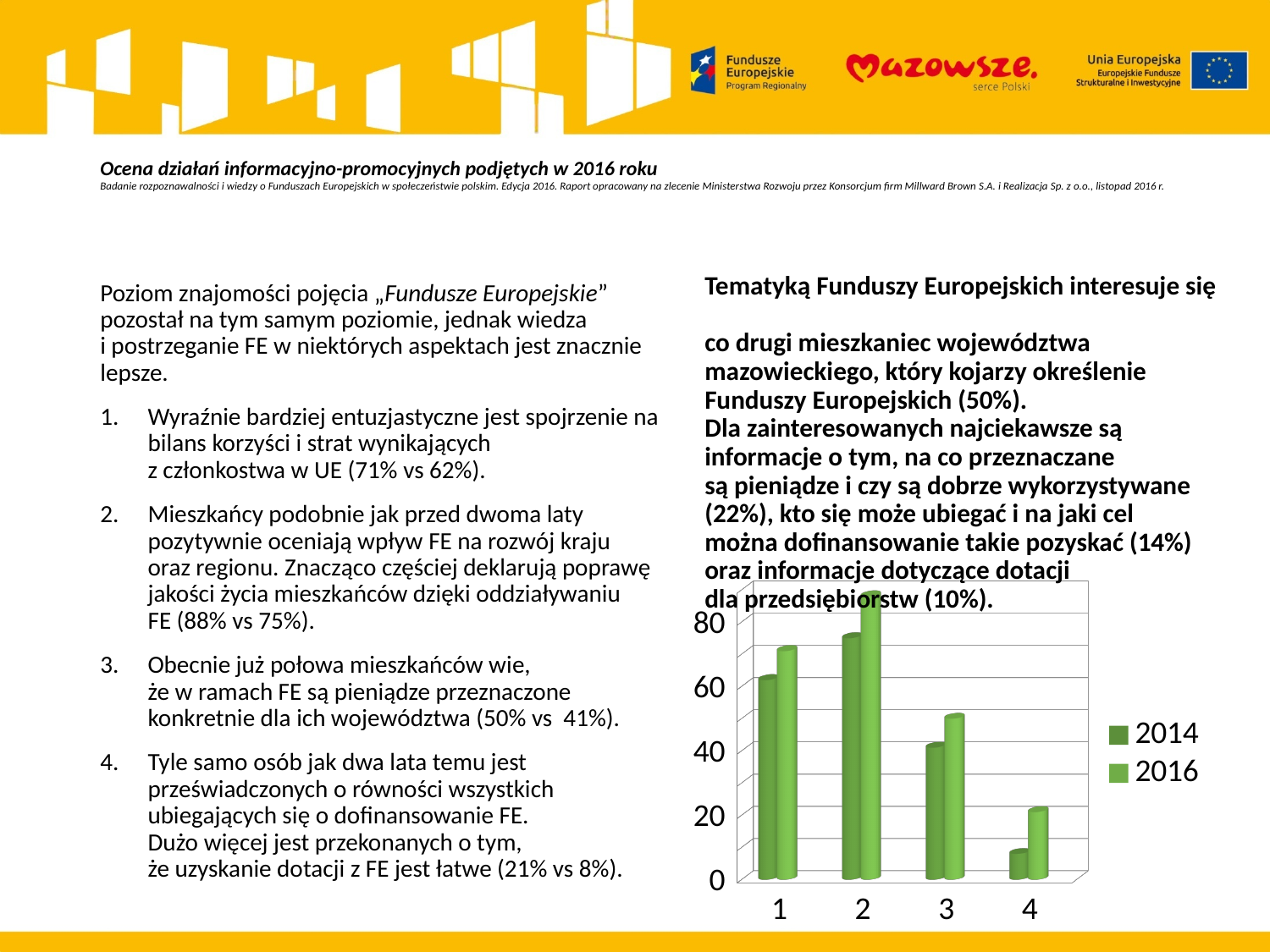
What kind of chart is shown on the slide? bar chart Which series are listed in the chart legend? 2014 and 2016 Is the 2016 value for category 2 greater or less than 80? greater Is the 2016 value for category 1 greater or less than 60? greater Is the 2014 value for category 4 greater or less than 20? less How many categories are shown on the x axis of the chart? 4 How many series does the chart legend list? 2 For category 1, which series has the larger value, 2014 or 2016? 2016 Do the 2016 values rise or fall from category 2 to category 4? fall Which category has the shortest bar in the chart? 4 For category 4, which series has the larger value, 2014 or 2016? 2016 Which category has the tallest bar in the chart? 2